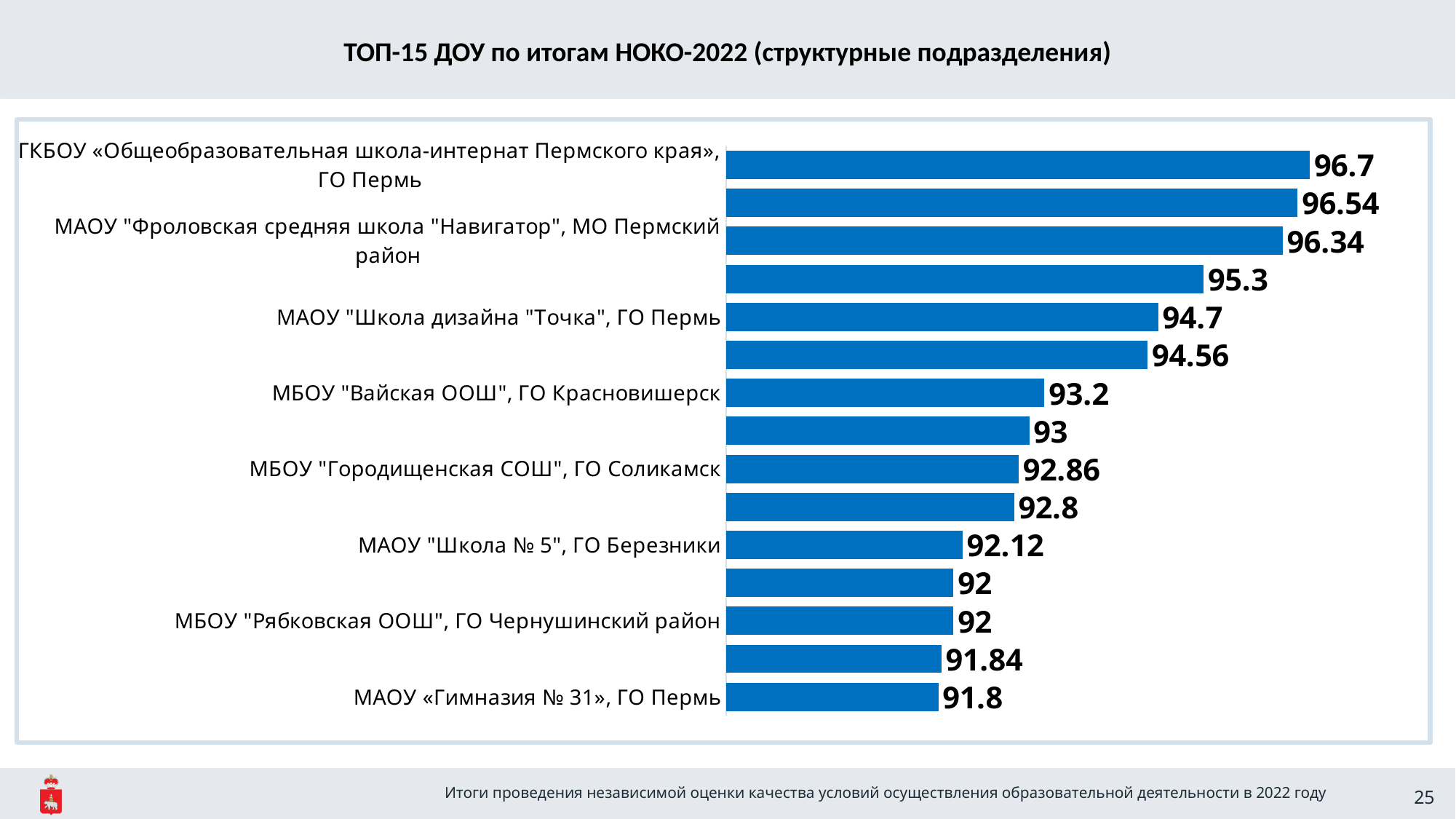
Which has a larger value: МАОУ "Школа дизайна "Точка", ГО Пермь or МБОУ "Вайская ООШ", ГО Красновишерск? МАОУ "Школа дизайна "Точка", ГО Пермь What is the value for МБОУ "Городищенская СОШ", ГО Соликамск? 92.86 What is the value for МБОУ "Вайская ООШ", ГО Красновишерск? 93.2 What is the difference between the values for ГКБОУ «Общеобразовательная школа-интернат Пермского края», ГО Пермь and МАОУ «Гимназия № 31», ГО Пермь? 4.9 What is the title of the chart on the slide? ТОП-15 ДОУ по итогам НОКО-2022 (структурные подразделения) What is the value for ГКБОУ «Общеобразовательная школа-интернат Пермского края», ГО Пермь? 96.7 What is the value for МАОУ "Школа дизайна "Точка", ГО Пермь? 94.7 What type of chart is shown on the slide? bar chart Which institution has the highest value in the chart? ГКБОУ «Общеобразовательная школа-интернат Пермского края», ГО Пермь What is the value for МАОУ «Гимназия № 31», ГО Пермь? 91.8 How many bars are plotted in the chart? 15 Which institution has the lowest value in the chart? МАОУ «Гимназия № 31», ГО Пермь